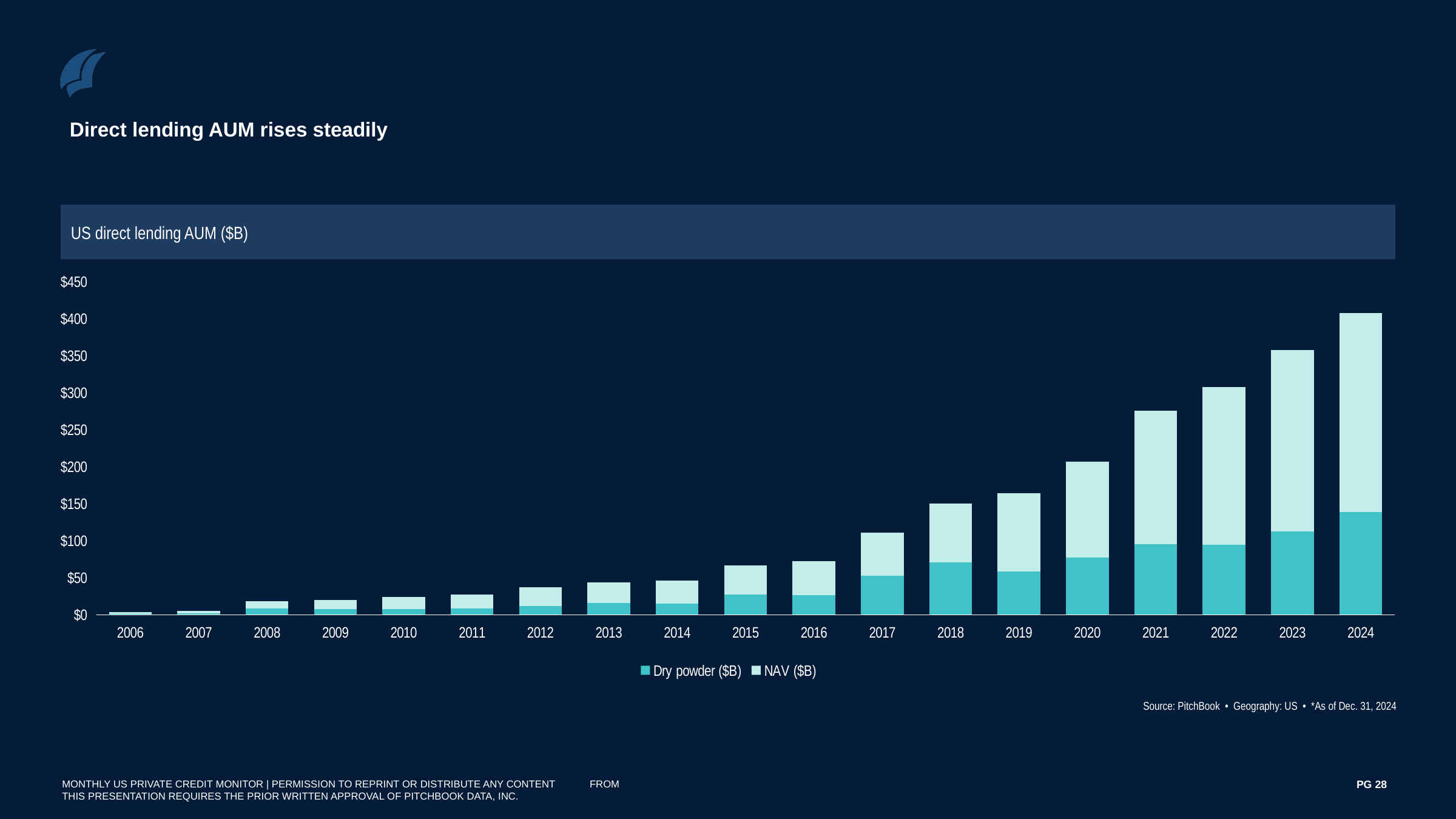
How many series does the legend list? 2 Do the total AUM values rise or fall from 2006 to 2024? rise Which year has the highest total US direct lending AUM? 2024 Is the total AUM for 2016 greater or less than $100? less Is the total AUM for 2020 greater or less than $200? greater Is the Dry powder ($B) value for 2024 greater or less than $150? less Which year has the lowest total US direct lending AUM? 2006 What is the title of the chart? US direct lending AUM ($B) What kind of chart is shown on the slide? bar chart Which year has the larger total AUM, 2019 or 2021? 2021 How many years are shown on the x axis of the chart? 19